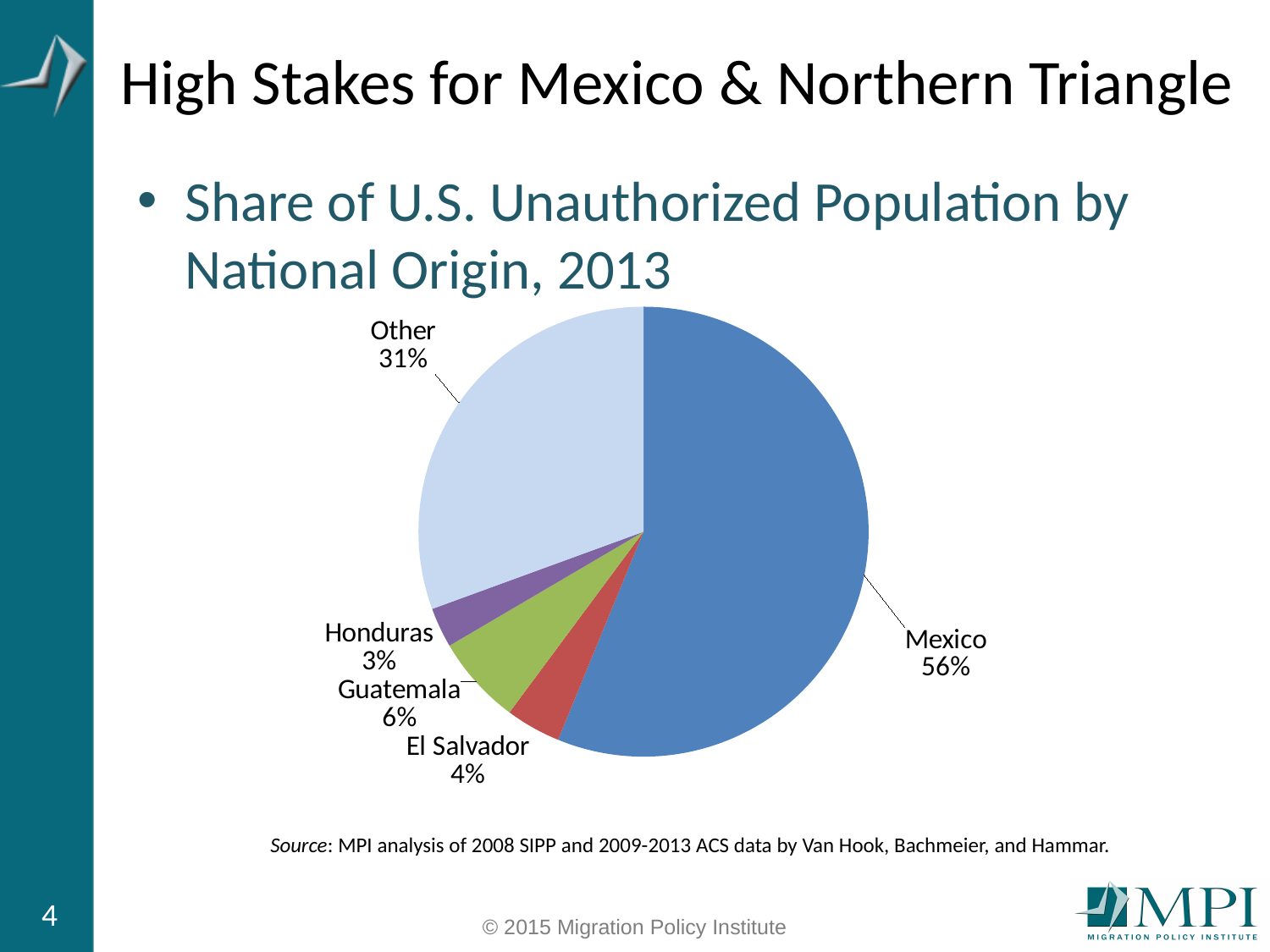
What kind of chart is shown on the slide? pie chart What is the combined share of Guatemala, El Salvador and Honduras? 13% How many slices does the pie chart have? 5 What is the difference in percentage points between the Mexico share and the Other share? 25 What share of the U.S. unauthorized population is from Mexico? 56% What share of the U.S. unauthorized population is from Honduras? 3% What share of the U.S. unauthorized population is from Guatemala? 6% Which national origin has the smallest share of the pie? Honduras What share of the U.S. unauthorized population is labelled Other? 31% What share of the U.S. unauthorized population is from El Salvador? 4% Which national origin has the largest share of the pie? Mexico Which is larger, the share for Guatemala or the share for El Salvador? Guatemala